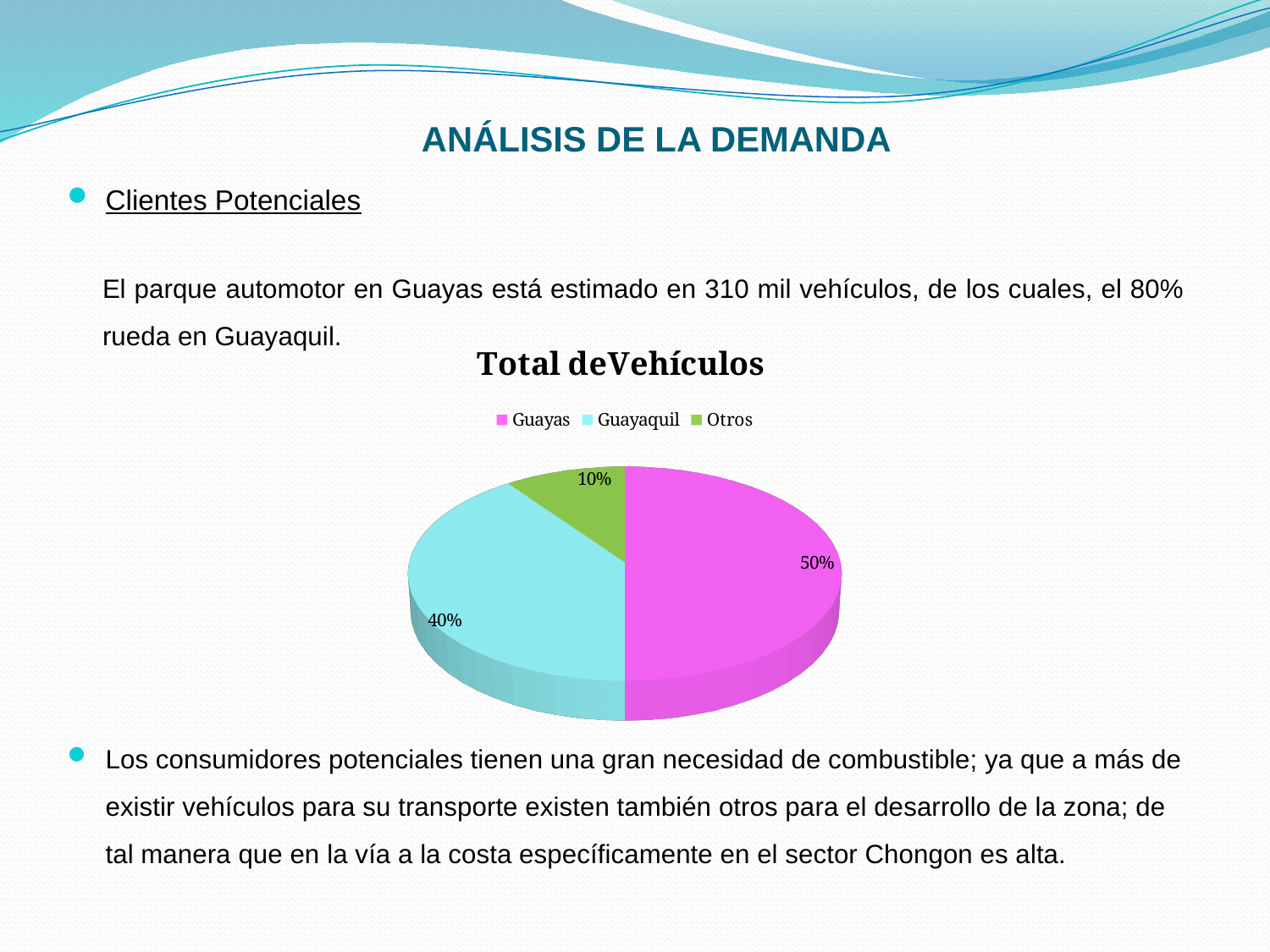
Which category has the smallest slice of the pie? Otros How many slices does the pie chart have? 3 What share of the pie does Guayaquil represent? 40% Which category has the largest slice of the pie? Guayas What share of the pie does Guayas represent? 50% Which is larger, the Guayaquil slice or the Otros slice? Guayaquil How many entries does the legend list? 3 What is the title of the chart? Total deVehículos What is the difference in percentage points between the Guayas and Guayaquil slices? 10% What share of the pie does Otros represent? 10% What colour is the Guayaquil slice? light blue What kind of chart is shown on the slide? pie chart